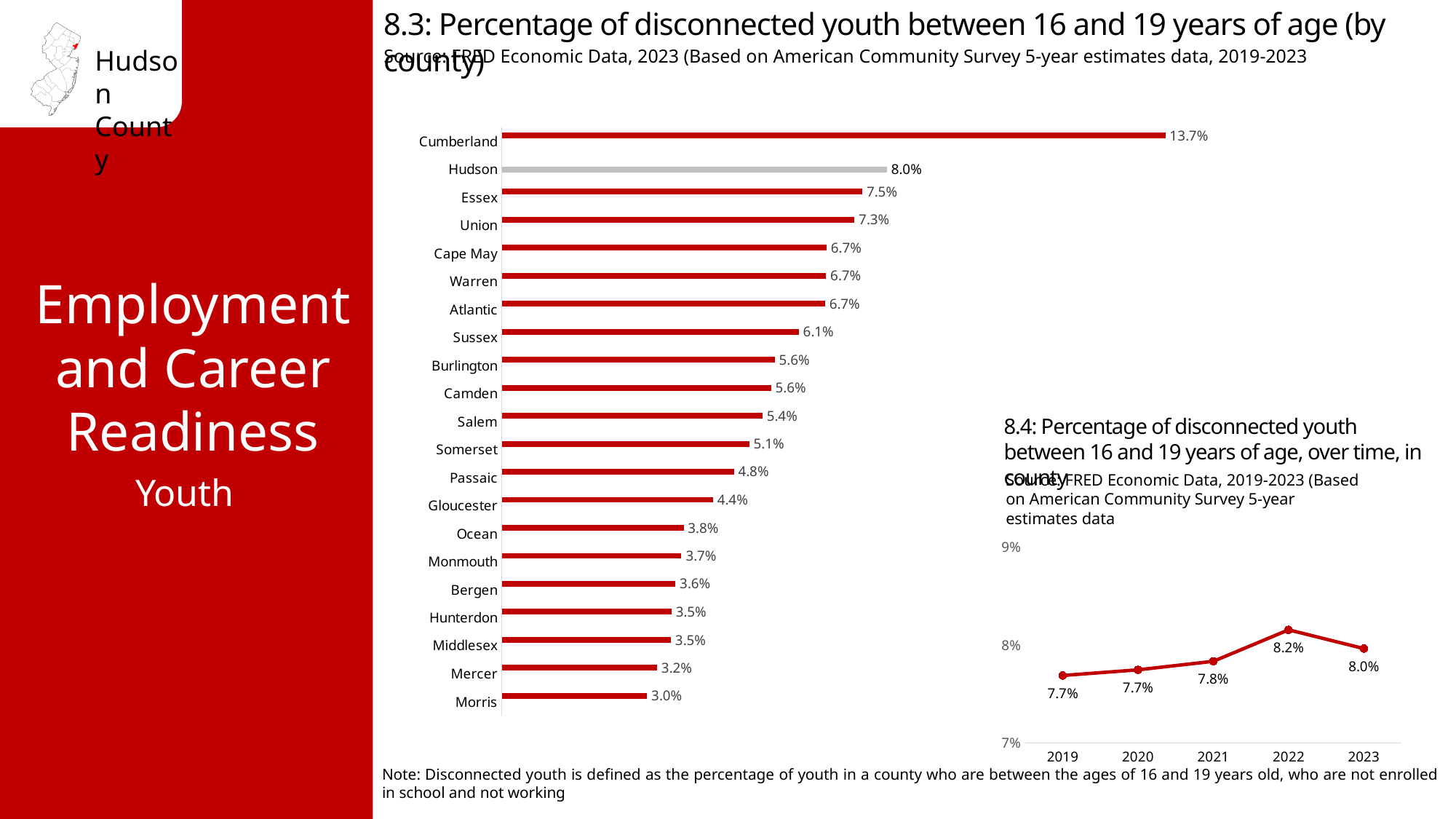
In the chart 8.3 (by county), what is the value for Hudson? 8.0% In the chart 8.3 (by county), what is the difference between the values for Cumberland and Hudson? 5.7% In the chart 8.3 (by county), how many counties are shown? 21 What kind of chart is chart 8.3 (by county)? Bar chart In the chart 8.3 (by county), which is larger, the value for Essex or the value for Union? Essex In the chart 8.3 (by county), which county has the lowest percentage of disconnected youth? Morris In the chart 8.4 (over time), how many years are plotted? 5 In the chart 8.3 (by county), which county has the highest percentage of disconnected youth? Cumberland In the chart 8.4 (over time), which year has the highest value? 2022 In the chart 8.4 (over time), what is the difference between the values for 2022 and 2019? 0.5% In the chart 8.3 (by county), what is the value for Cumberland? 13.7% In the chart 8.4 (over time), what is the value for 2022? 8.2%